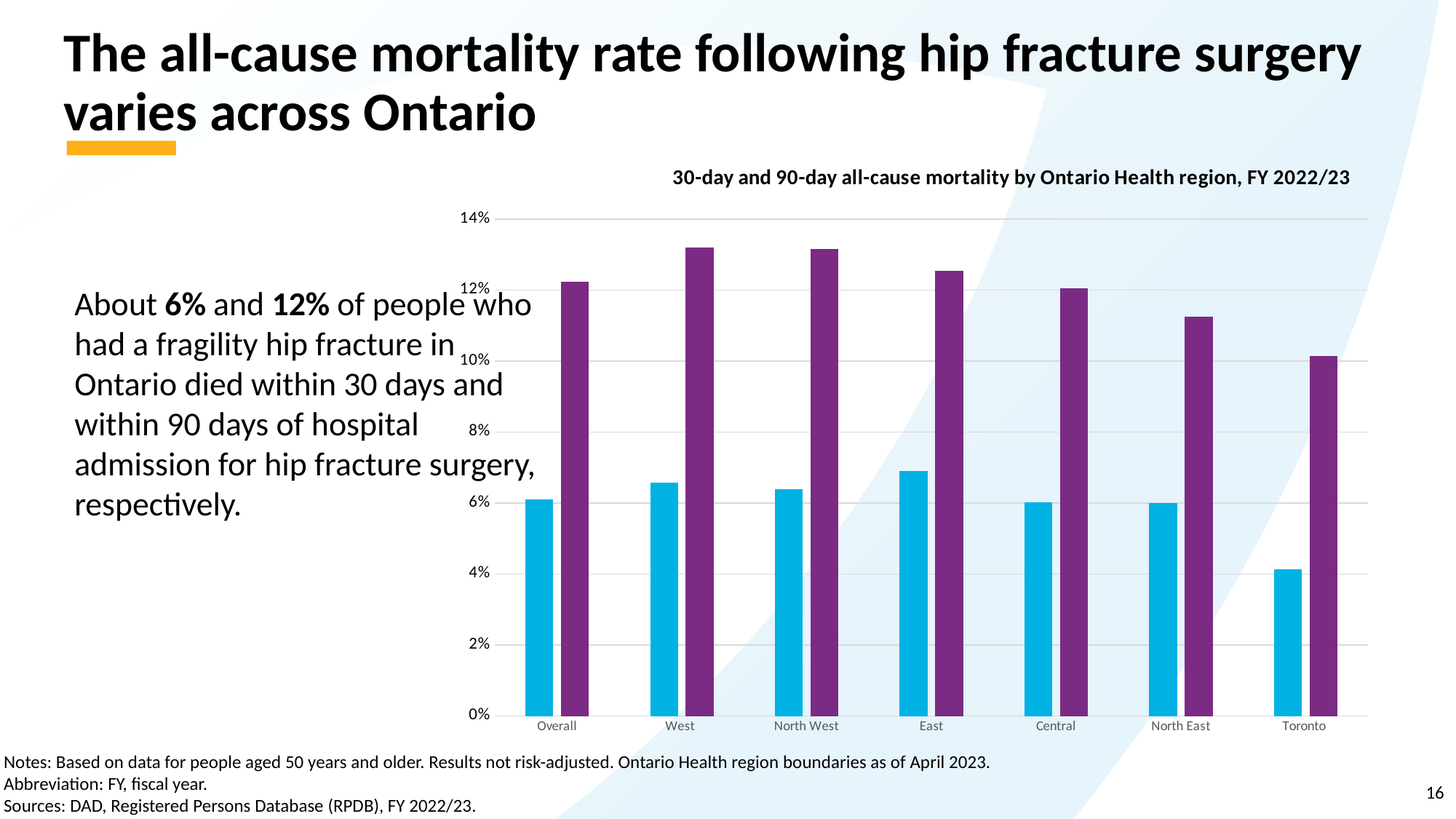
What kind of chart is shown on the slide? Bar chart Is the purple bar for Toronto greater or less than 12%? less Which region has the lowest value among the purple bars? Toronto Is the purple bar for North East greater or less than 10%? greater Which region has the lowest value among the blue bars? Toronto How many Ontario Health region categories are shown on the x axis of the chart? 7 For the Overall category, which bar is taller, the blue bar or the purple bar? The purple bar Is the purple bar for West greater or less than 12%? greater What is the title of the chart? 30-day and 90-day all-cause mortality by Ontario Health region, FY 2022/23 Do the purple bars rise or fall moving along the x axis from West to Toronto? Fall